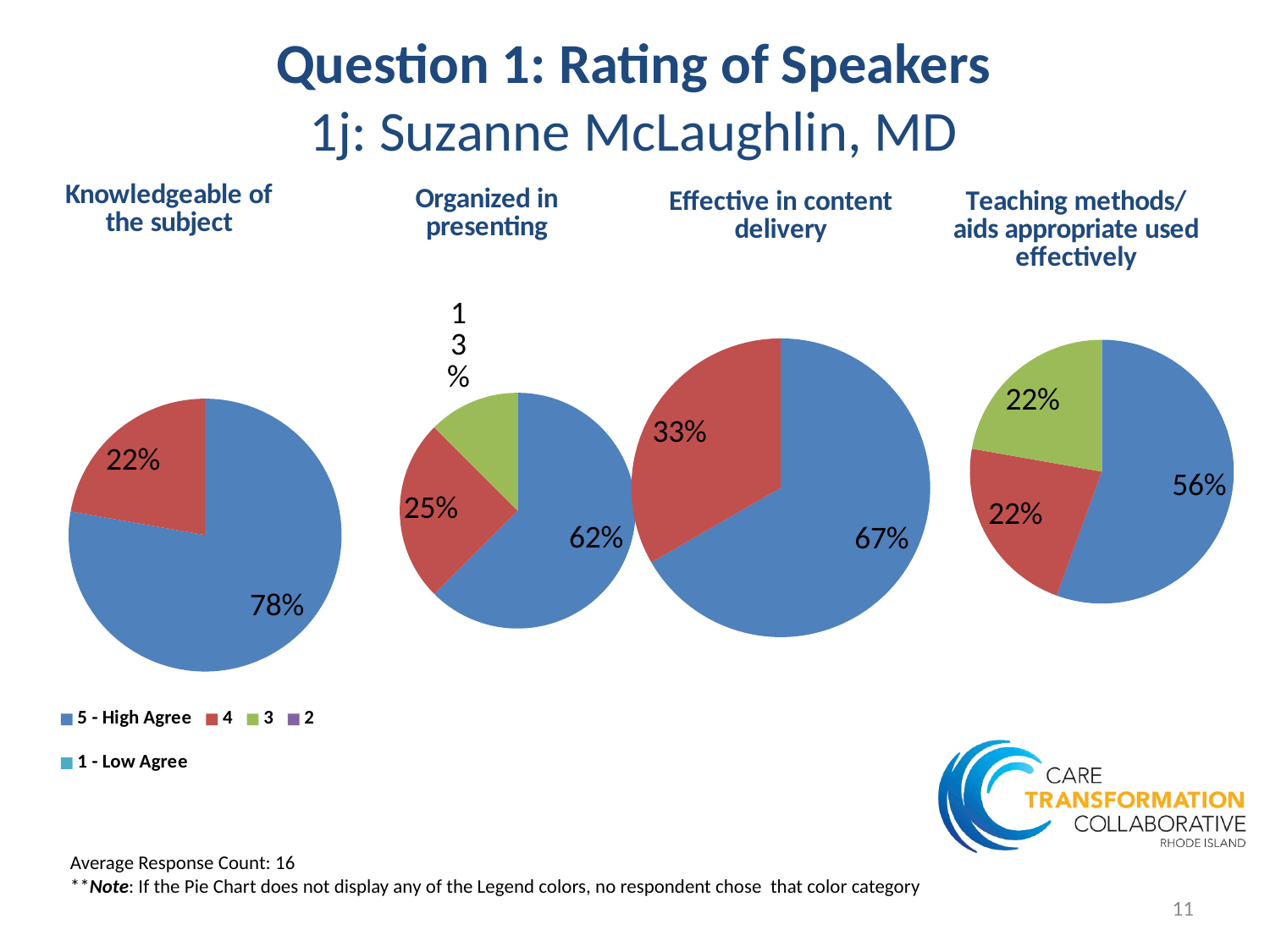
In the 'Teaching methods/aids appropriate used effectively' pie chart, what share of respondents chose '5 - High Agree'? 56% In the 'Knowledgeable of the subject' pie chart, what is the difference between the '5 - High Agree' share and the '4' share? 56% What type of chart is used on this slide? Pie chart In the 'Organized in presenting' pie chart, which rating category has the smallest slice? 3 In the 'Knowledgeable of the subject' pie chart, what share of respondents chose '5 - High Agree'? 78% In the 'Effective in content delivery' pie chart, what share of respondents chose '4'? 33% How many slices does the 'Teaching methods/aids appropriate used effectively' pie chart have? 3 Which is larger: the '5 - High Agree' share in the 'Knowledgeable of the subject' chart or the '5 - High Agree' share in the 'Effective in content delivery' chart? Knowledgeable of the subject In the 'Effective in content delivery' pie chart, which rating category has the largest slice? 5 - High Agree